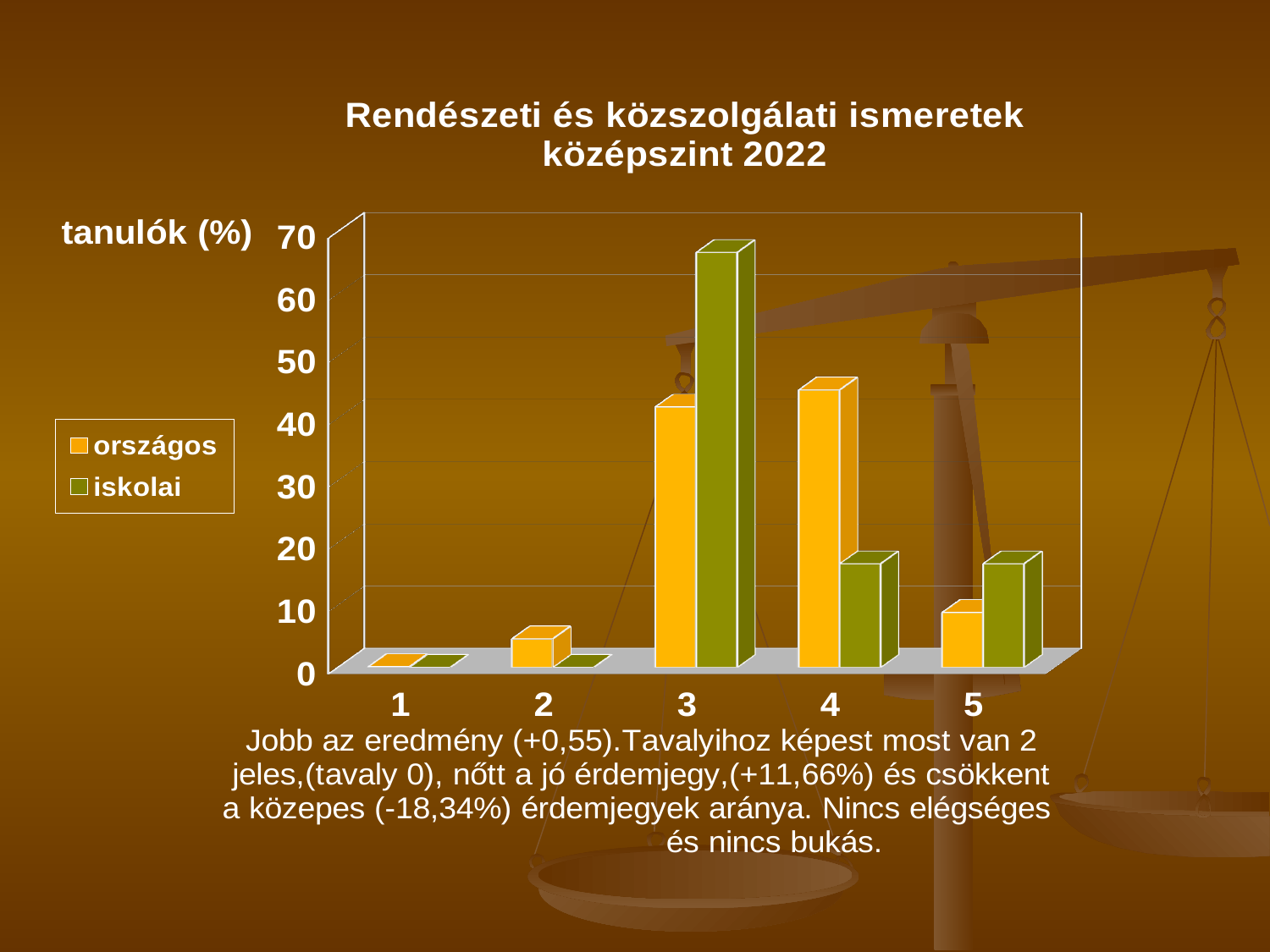
For the országos series, which category has the highest value? 4 For category 4, which series has the larger value, országos or iskolai? országos Is the iskolai value for category 4 greater or less than 20? less What is the label of the vertical axis? tanulók (%) Is the országos value for category 3 greater or less than 40? greater For the iskolai series, which category has the highest value? 3 How many categories are shown on the x axis? 5 Which series are listed in the legend? országos, iskolai What kind of chart is shown on the slide? bar chart How many series does the legend list? 2 For category 3, which series has the larger value, országos or iskolai? iskolai Is the iskolai value for category 3 greater or less than 60? greater